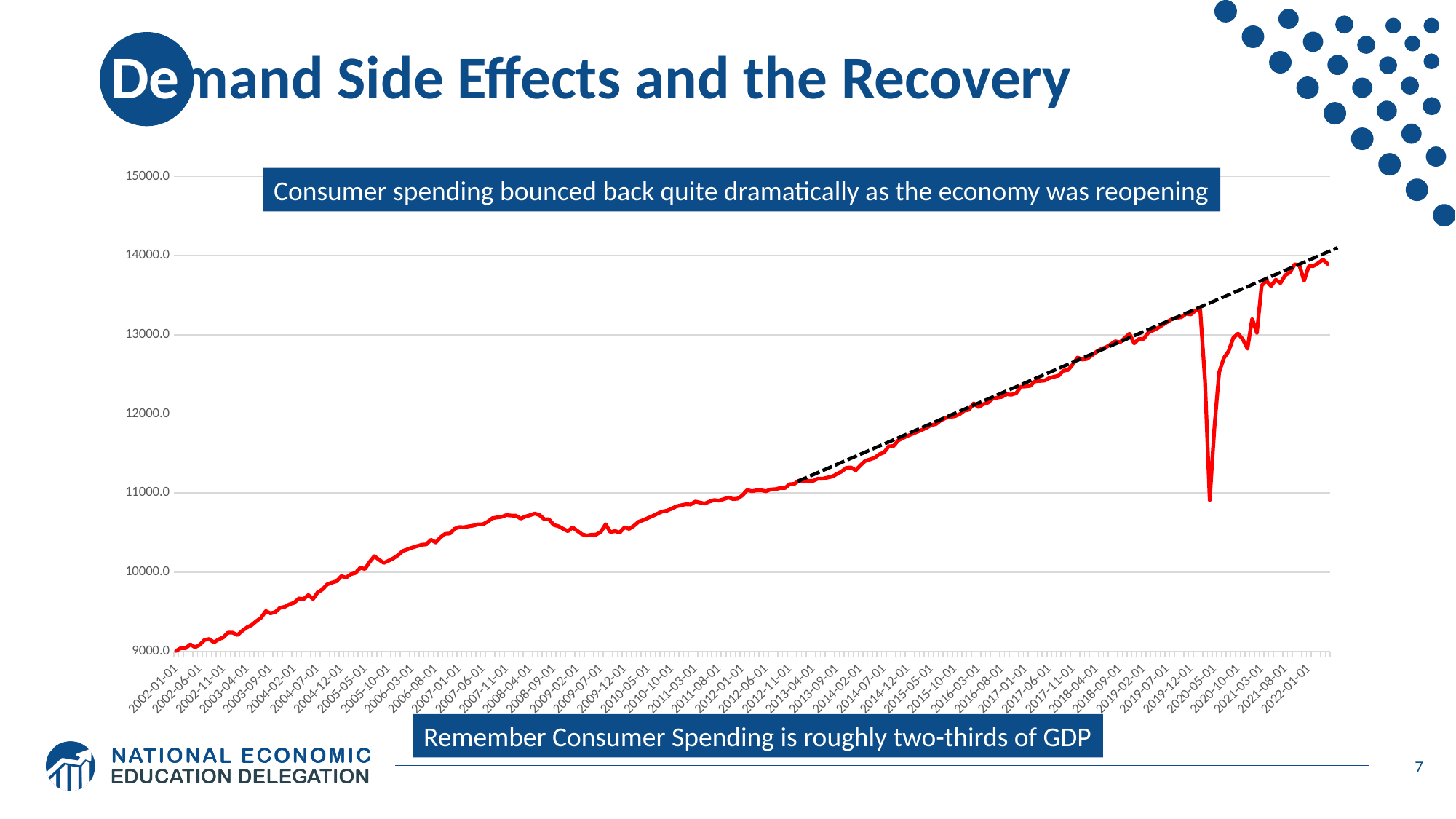
Is the value of the red line at 2008-04-01 greater or less than 10000.0? greater Is the value of the red line at 2012-01-01 greater or less than 12000.0? less Overall, do the values of the red line rise or fall from 2002-01-01 to 2022-01-01? rise Is the value of the red line at 2019-12-01 greater or less than 13000.0? greater What is the lowest value shown on the y axis? 9000.0 Around which x-axis date does the red line show its sharpest drop? 2020-05-01 What kind of chart is shown on the slide? line chart What colour is the dashed trend line on the chart? black Which is larger, the value of the red line at 2008-04-01 or at 2009-07-01? 2008-04-01